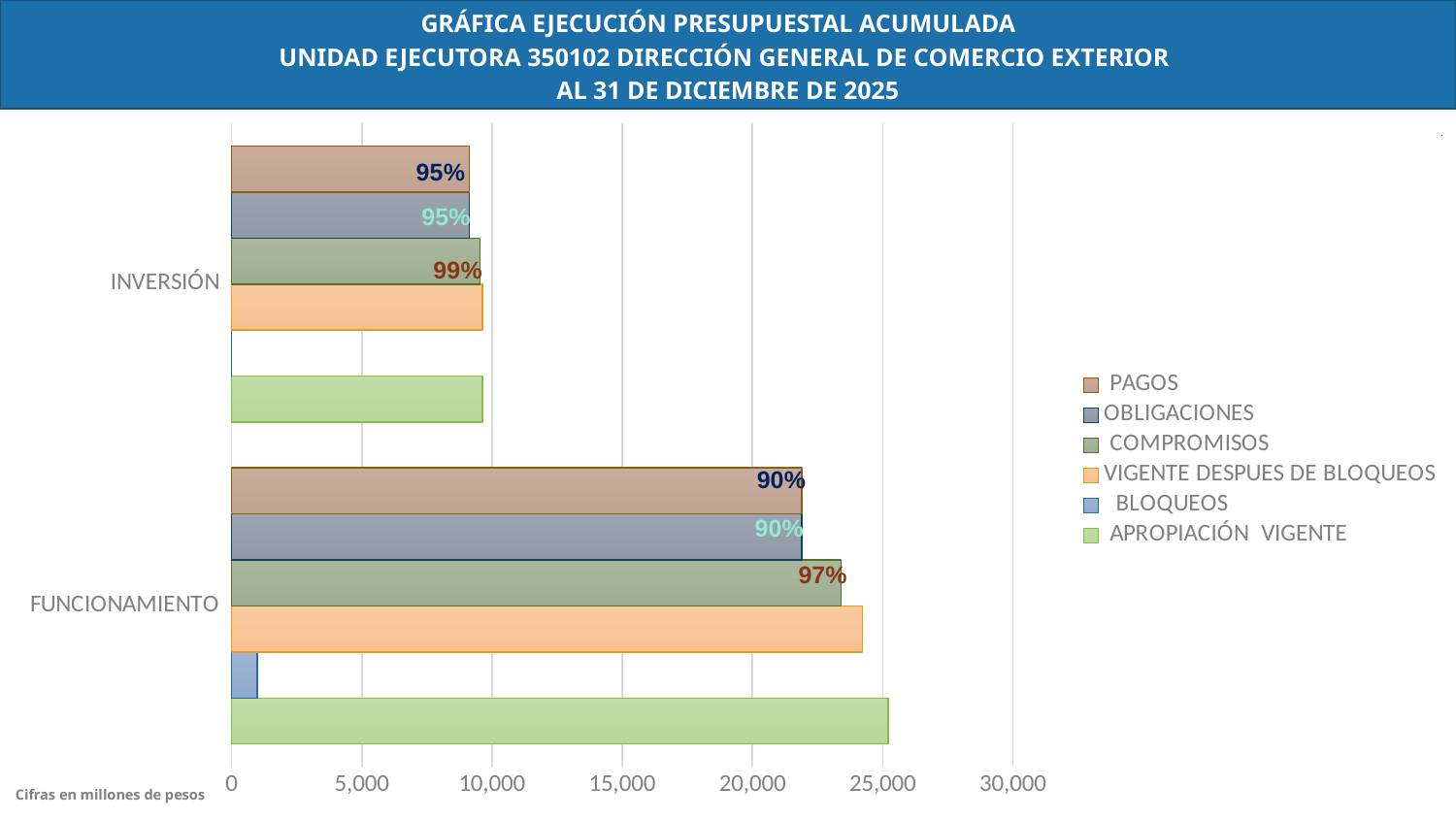
What percentage is labelled on the PAGOS bar for INVERSIÓN? 95% How many categories are shown on the vertical axis of the chart? 2 What kind of chart is shown on the slide? bar chart Is the value for BLOQUEOS in FUNCIONAMIENTO greater or less than 5,000? less What percentage is labelled on the COMPROMISOS bar for FUNCIONAMIENTO? 97% What percentage is labelled on the COMPROMISOS bar for INVERSIÓN? 99% How many series does the legend list? 6 Which category has the larger APROPIACIÓN VIGENTE bar, INVERSIÓN or FUNCIONAMIENTO? FUNCIONAMIENTO According to the note at the bottom left of the slide, in what units are the figures expressed? millones de pesos Is the value for PAGOS in FUNCIONAMIENTO greater or less than 20,000? greater What percentage is labelled on the OBLIGACIONES bar for FUNCIONAMIENTO? 90% What is the difference between the COMPROMISOS percentage for INVERSIÓN and for FUNCIONAMIENTO? 2 percentage points